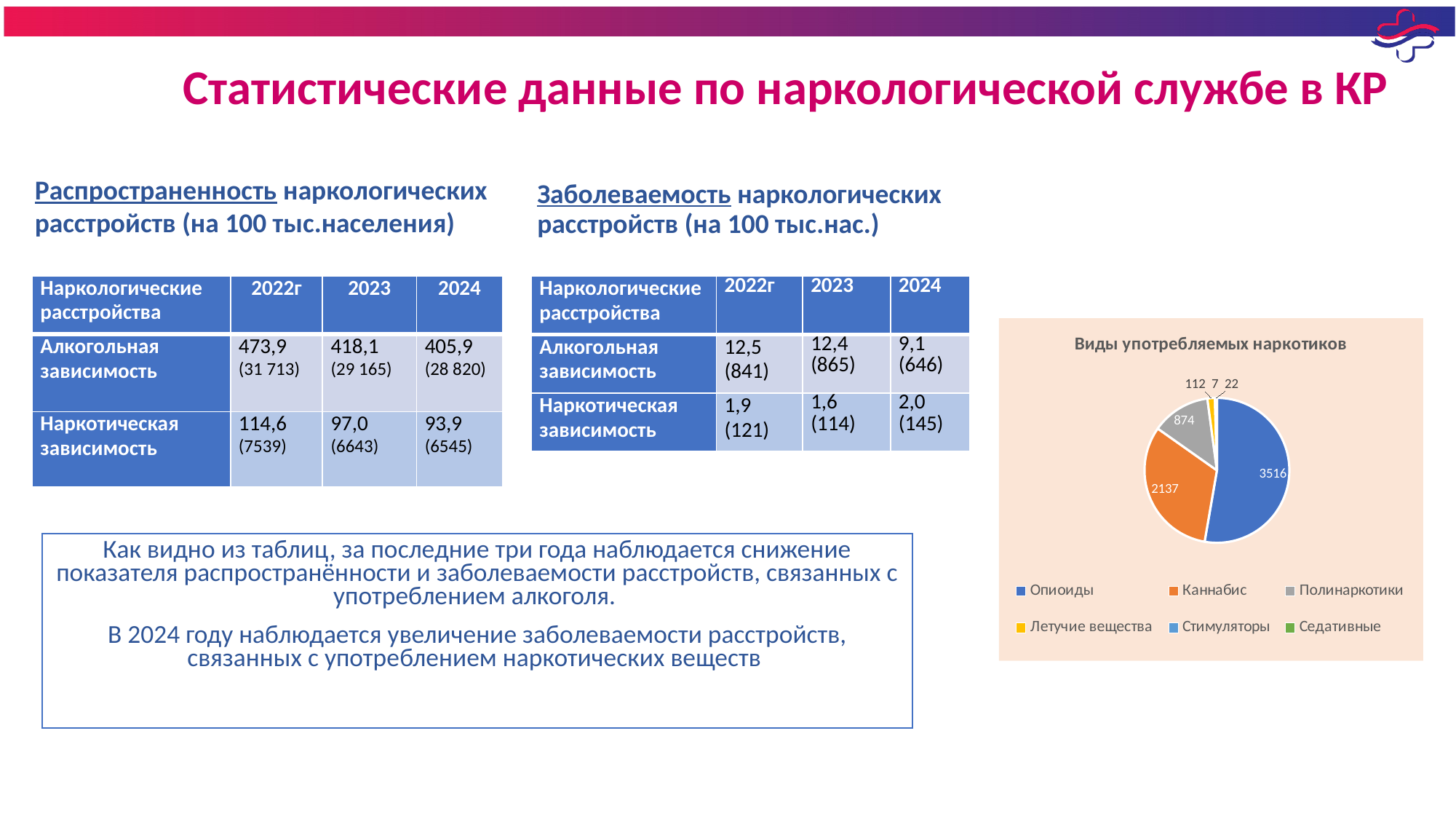
What is the value for Опиоиды in the pie chart? 3516 What is the difference between the values for Опиоиды and Каннабис in the pie chart? 1379 What is the value for Летучие вещества in the pie chart? 112 What is the value for Каннабис in the pie chart? 2137 What is the difference between the values for Каннабис and Полинаркотики in the pie chart? 1263 What is the title of the pie chart? Виды употребляемых наркотиков Which category has the largest slice in the pie chart? Опиоиды What is the value for Полинаркотики in the pie chart? 874 What kind of chart is shown on the slide? Pie chart How many categories does the legend of the pie chart list? 6 What colour is the Опиоиды slice in the pie chart? Blue Which is larger in the pie chart, Каннабис or Полинаркотики? Каннабис